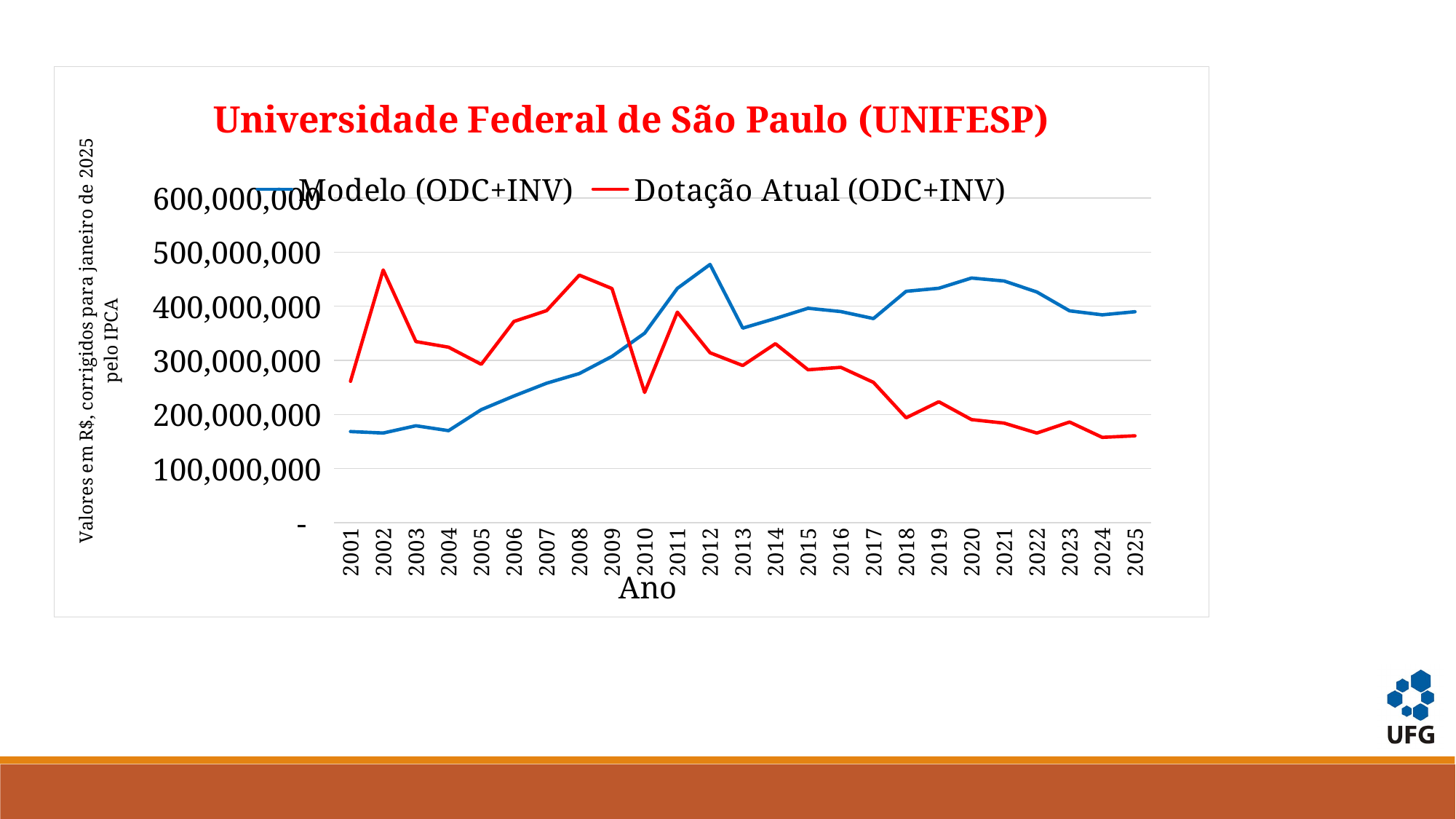
Does the Modelo (ODC+INV) series generally rise or fall from 2001 to 2012? rise Is the value of Dotação Atual (ODC+INV) in 2010 greater or less than 300,000,000? less What is the label of the x axis? Ano What kind of chart is shown on the slide? line chart Is the value of Dotação Atual (ODC+INV) in 2002 greater or less than 400,000,000? greater How many series does the legend list? 2 What is the title of the chart? Universidade Federal de São Paulo (UNIFESP) In which year does the Modelo (ODC+INV) series reach its highest value? 2012 Is the value of Modelo (ODC+INV) in 2012 greater or less than 400,000,000? greater In 2025, which series has the larger value, Modelo (ODC+INV) or Dotação Atual (ODC+INV)? Modelo (ODC+INV) How many years are plotted along the x axis? 25